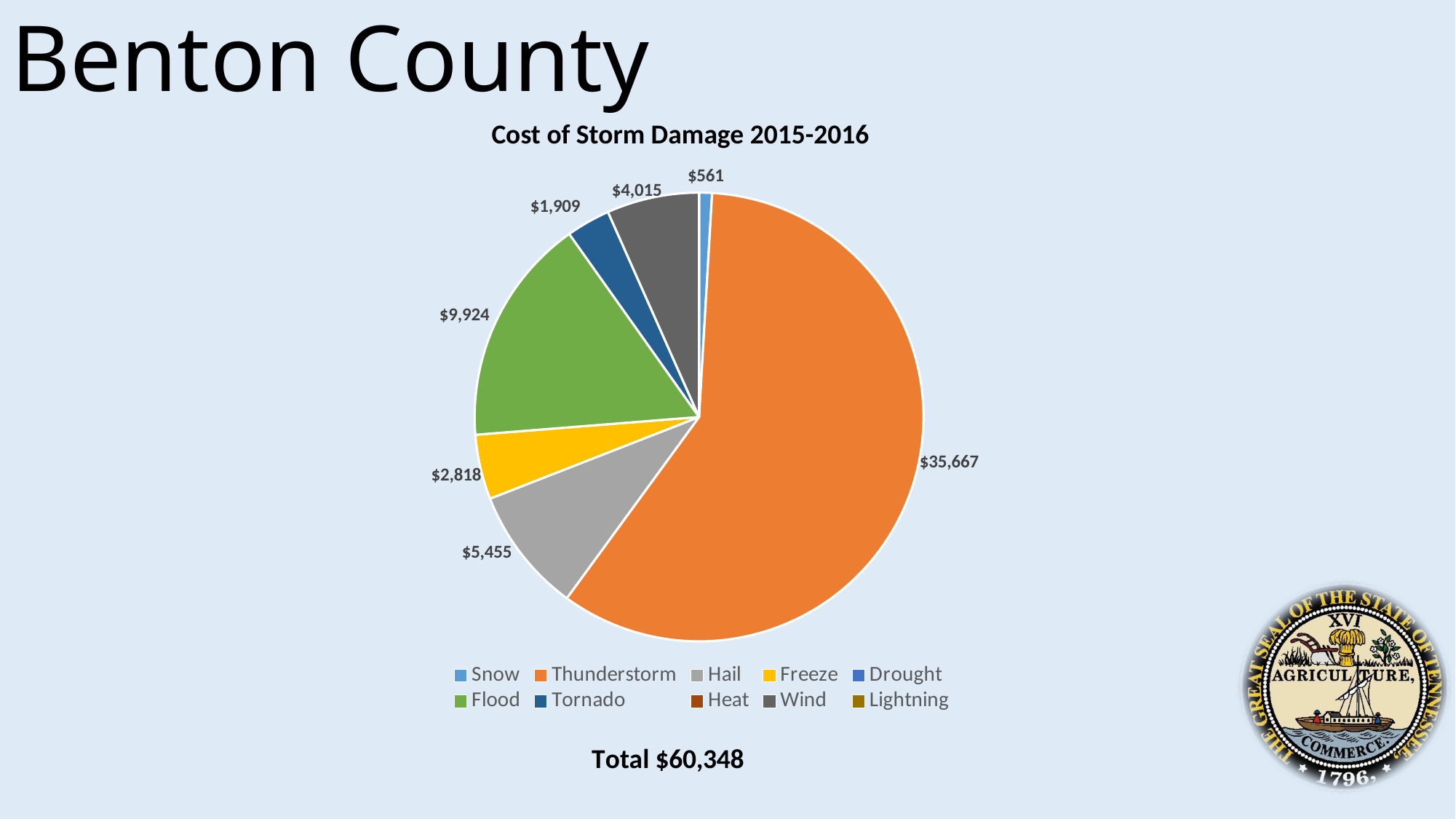
What is the cost of storm damage attributed to Snow? $561 Which has a higher cost of damage, Freeze or Tornado? Freeze How many storm types are listed in the legend? 10 Which storm type accounts for the largest cost of damage? Thunderstorm What is the cost of storm damage attributed to Hail? $5,455 What is the title of the chart? Cost of Storm Damage 2015-2016 What is the difference between the Flood cost and the Hail cost? $4,469 What is the cost of storm damage attributed to Flood? $9,924 What kind of chart is shown on the slide? Pie chart What is the cost of storm damage attributed to Wind? $4,015 Which storm type with a visible slice accounts for the smallest cost of damage? Snow What is the cost of storm damage attributed to Thunderstorm? $35,667